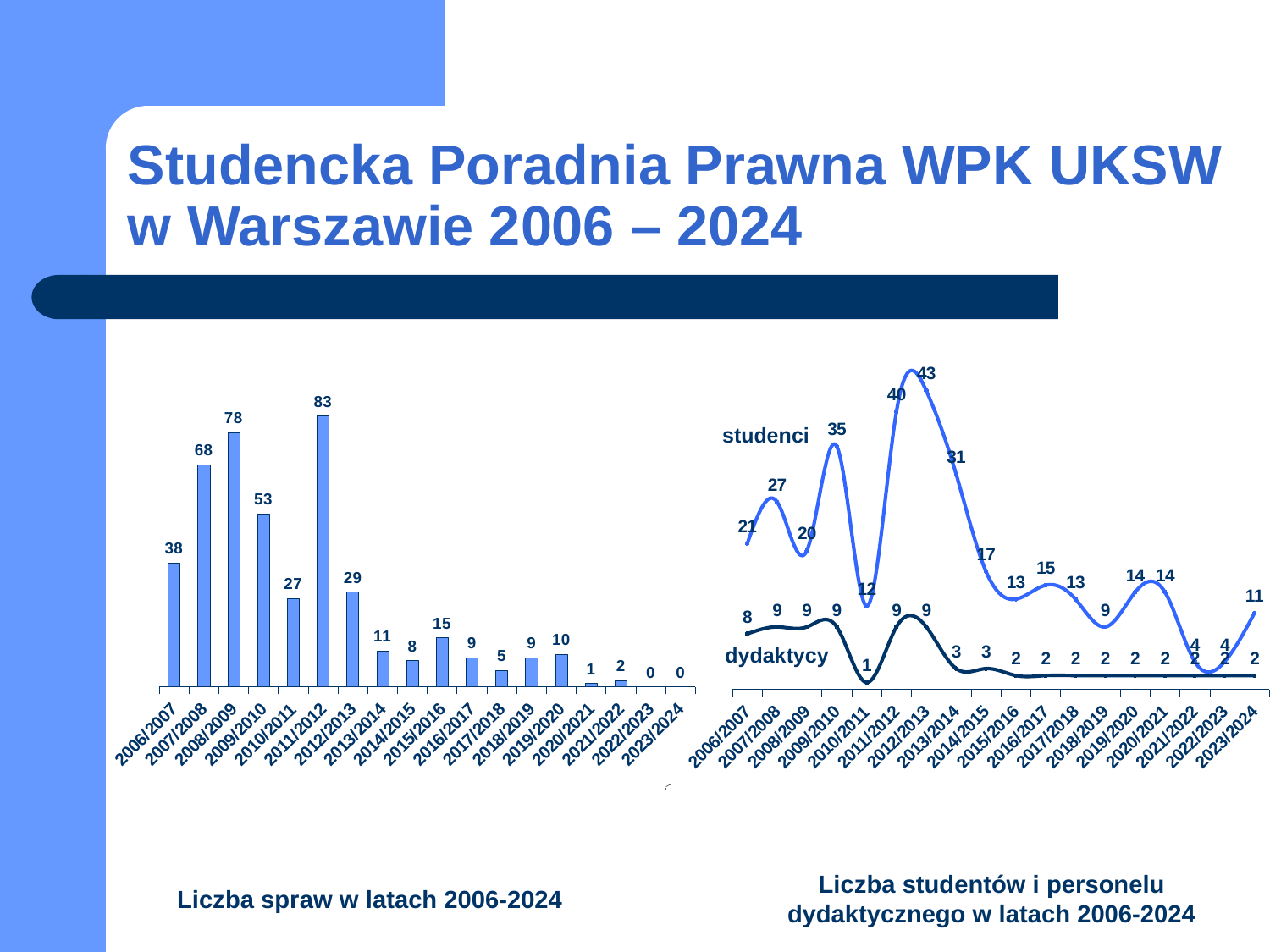
In the line chart 'Liczba studentów i personelu dydaktycznego w latach 2006-2024', what is the difference between the 'studenci' and 'dydaktycy' values for 2009/2010? 26 In the bar chart 'Liczba spraw w latach 2006-2024', what is the value for 2008/2009? 78 In the bar chart 'Liczba spraw w latach 2006-2024', what is the difference between the values for 2007/2008 and 2009/2010? 15 How many years are shown on the x axis of the bar chart 'Liczba spraw w latach 2006-2024'? 18 In the bar chart 'Liczba spraw w latach 2006-2024', which is larger: the value for 2010/2011 or the value for 2012/2013? 2012/2013 In the line chart 'Liczba studentów i personelu dydaktycznego w latach 2006-2024', which year has the lowest value for the 'dydaktycy' series? 2010/2011 In the line chart 'Liczba studentów i personelu dydaktycznego w latach 2006-2024', what is the value of the 'dydaktycy' series for 2010/2011? 1 How many series are plotted in the line chart 'Liczba studentów i personelu dydaktycznego w latach 2006-2024'? 2 What kind of chart is the chart on the left of the slide? bar chart In the bar chart 'Liczba spraw w latach 2006-2024', which year has the highest value? 2011/2012 In the line chart 'Liczba studentów i personelu dydaktycznego w latach 2006-2024', what is the value of the 'studenci' series for 2012/2013? 43 In the line chart 'Liczba studentów i personelu dydaktycznego w latach 2006-2024', does the 'studenci' series rise or fall from 2012/2013 to 2015/2016? fall